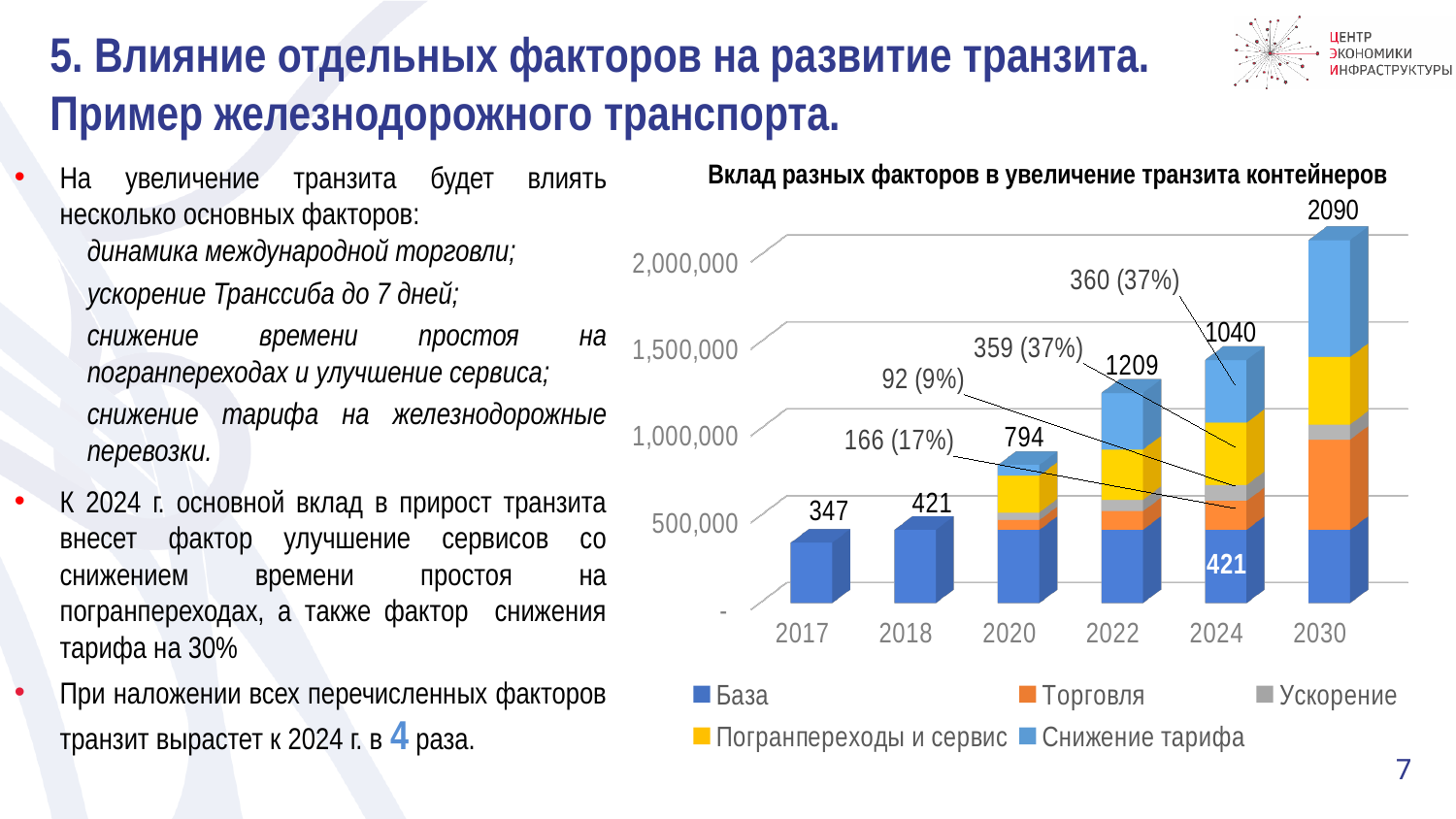
Which year has the tallest bar? 2030 What is the total value labelled for 2017? 347 What is the total value labelled for 2030? 2090 What is the difference between the labelled totals for 2018 and 2017? 74 What is the total value labelled for 2022? 1209 What value is labelled for the 'Торговля' segment of the 2024 bar? 166 (17%) What is the total value labelled for 2018? 421 How many series does the chart legend list? 5 What kind of chart is shown on the slide? Stacked bar chart How many years are shown on the x axis of the chart? 6 Do the bar totals rise or fall from 2017 to 2030? Rise What is the total value labelled for 2020? 794